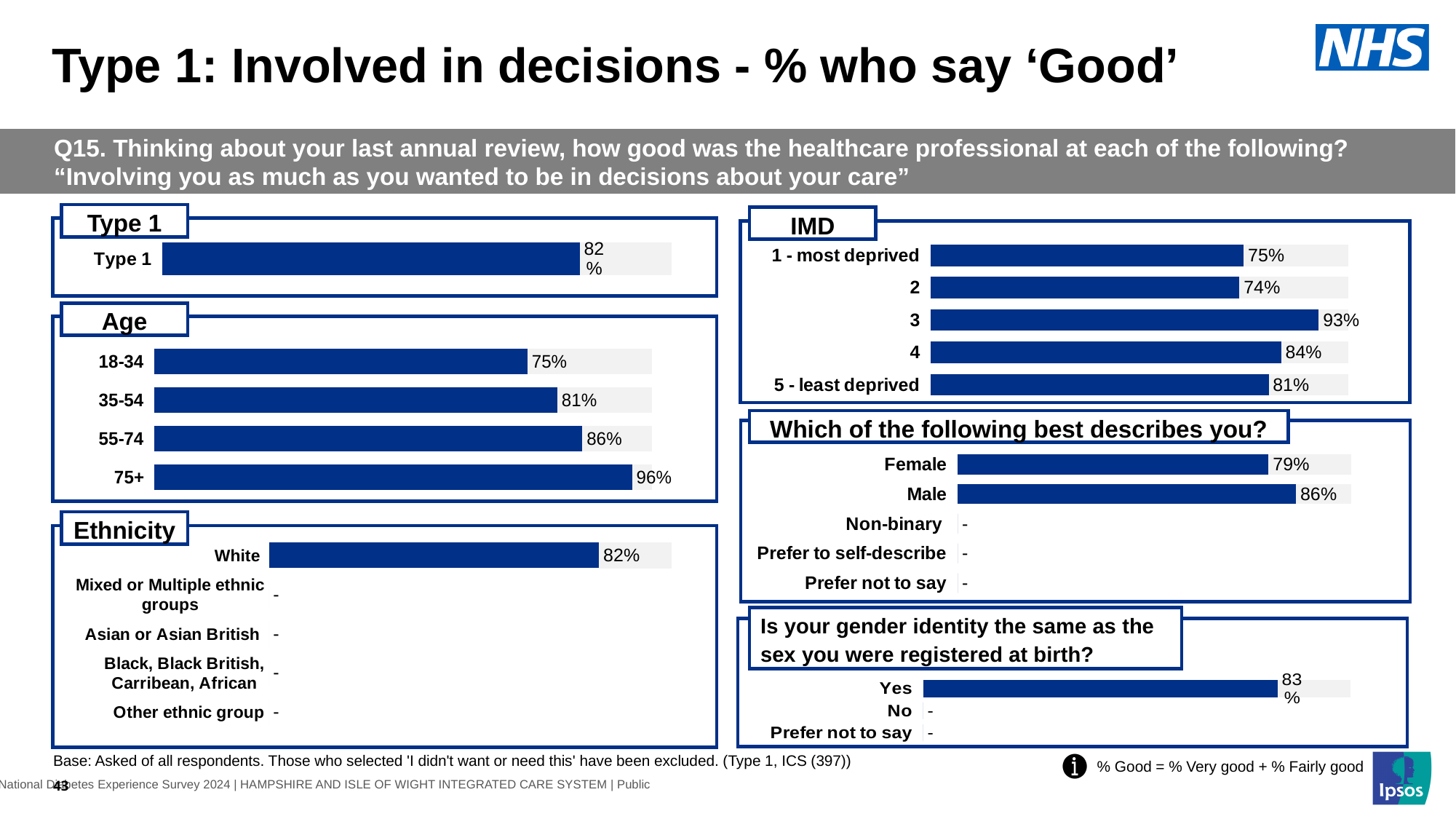
In the IMD chart, what is the value for '5 - least deprived'? 81% In the 'Is your gender identity the same as the sex you were registered at birth?' chart, what is the value for Yes? 83% In the IMD chart, what is the difference between the values for '3' and '2'? 19 percentage points In the Age chart, do the values rise or fall as age increases from 18-34 to 75+? Rise In the Age chart, which age group has the lowest value? 18-34 In the Ethnicity chart, what is the value for White? 82% In the Ethnicity chart, how many ethnic group categories are listed? 5 In the 'Which of the following best describes you?' chart, which is larger, Female or Male? Male In the 'Which of the following best describes you?' chart, what is the value for Female? 79% In the IMD chart, which category has the highest value? 3 In the Age chart, what is the value for the 75+ group? 96% What kind of chart is the IMD chart? Bar chart